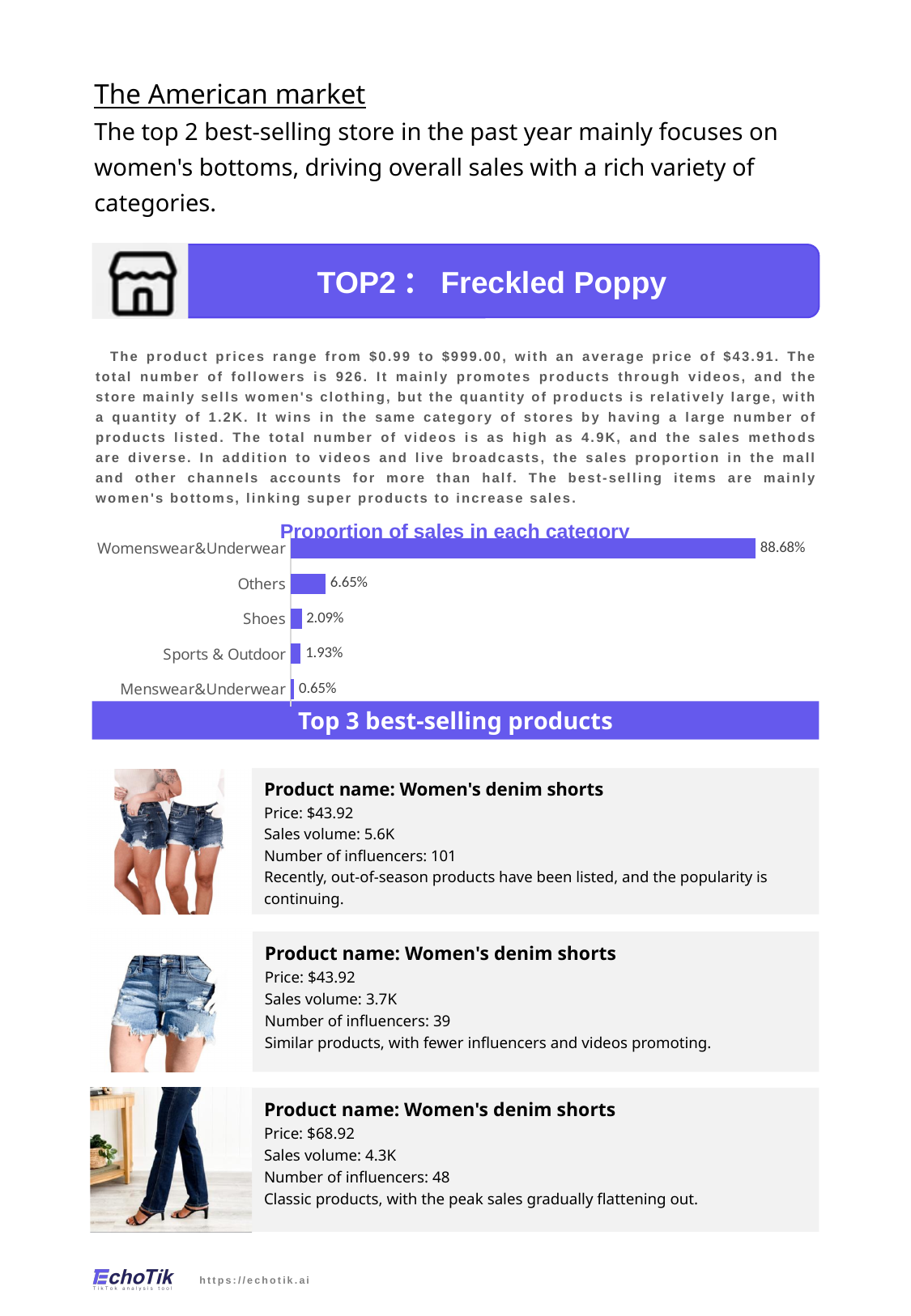
Which category has the lowest sales proportion in the chart? Menswear&Underwear What is the sales proportion for Menswear&Underwear in the chart? 0.65% Which has a larger sales proportion, Others or Shoes? Others What type of chart is used to show the proportion of sales in each category? Bar chart What is the sales proportion for Others in the chart? 6.65% Which category has the highest sales proportion in the chart? Womenswear&Underwear What is the sales proportion for Womenswear&Underwear in the 'Proportion of sales in each category' chart? 88.68% What is the difference in sales proportion between Others and Shoes? 4.56% What is the sales proportion for Sports & Outdoor in the chart? 1.93% What is the sales proportion for Shoes in the chart? 2.09% What is the difference in sales proportion between Womenswear&Underwear and Others? 82.03% How many categories are shown in the 'Proportion of sales in each category' chart? 5